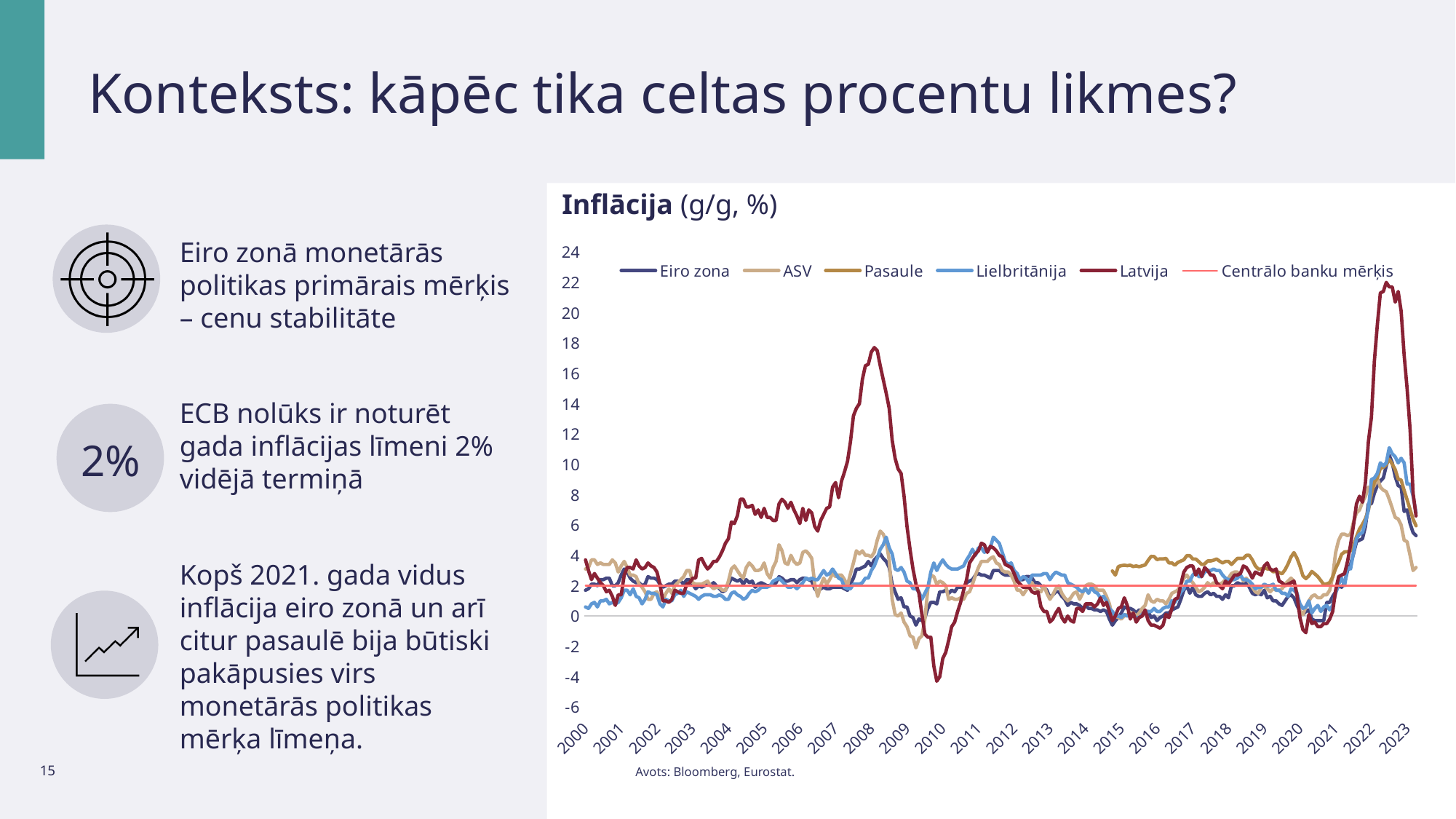
Does the Eiro zona series rise or fall from 2021 to 2022? rise How many series does the legend of the Inflācija chart list? 6 What source is cited below the chart? Bloomberg, Eurostat. Does the Latvija series rise or fall between its 2022 peak and 2023? fall At what level does the flat Centrālo banku mērķis line sit on the y axis? 2 Which series reaches the highest peak on the chart? Latvija Is the peak value of Latvija in 2022 greater or less than 20? greater Is the peak value of Latvija around 2008 greater or less than 16? greater What is the title of the chart? Inflācija (g/g, %) Is the lowest value of Latvija around 2010 greater or less than -2? less What kind of chart is shown on the slide? line chart How many year labels are shown on the x axis? 24